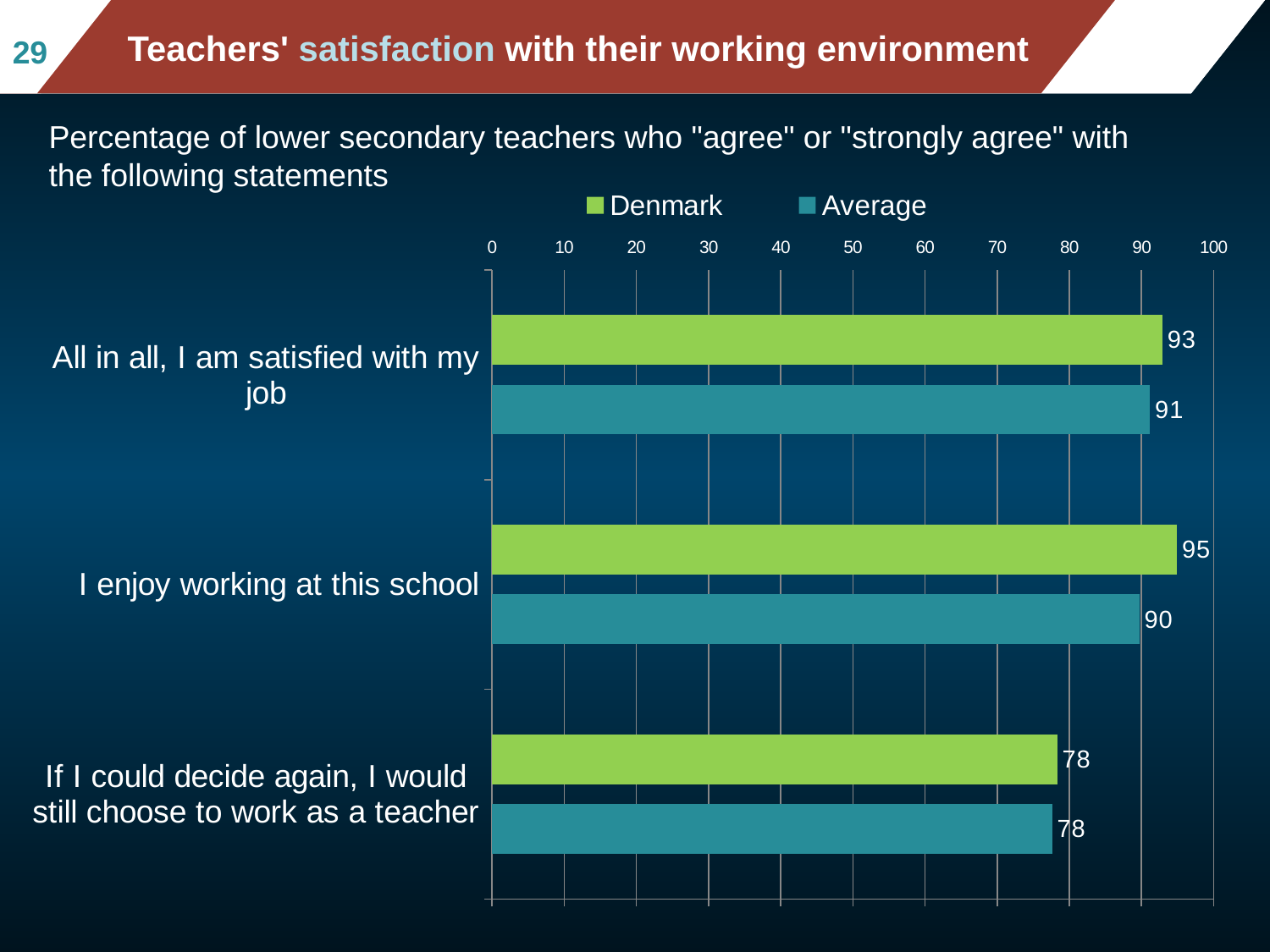
Which statement has the highest Denmark value? I enjoy working at this school What kind of chart is shown on the slide? Bar chart What is the Average value for "All in all, I am satisfied with my job"? 91 How many statements are shown on the chart? 3 Which statement has the lowest Average value? If I could decide again, I would still choose to work as a teacher What is the Denmark value for "If I could decide again, I would still choose to work as a teacher"? 78 Which series is shown in green in the legend? Denmark What is the Average value for "I enjoy working at this school"? 90 How many series does the legend list? 2 What is the difference between the Denmark and Average values for "I enjoy working at this school"? 5 What is the Denmark value for "All in all, I am satisfied with my job"? 93 For "All in all, I am satisfied with my job", which is larger: the Denmark value or the Average value? Denmark